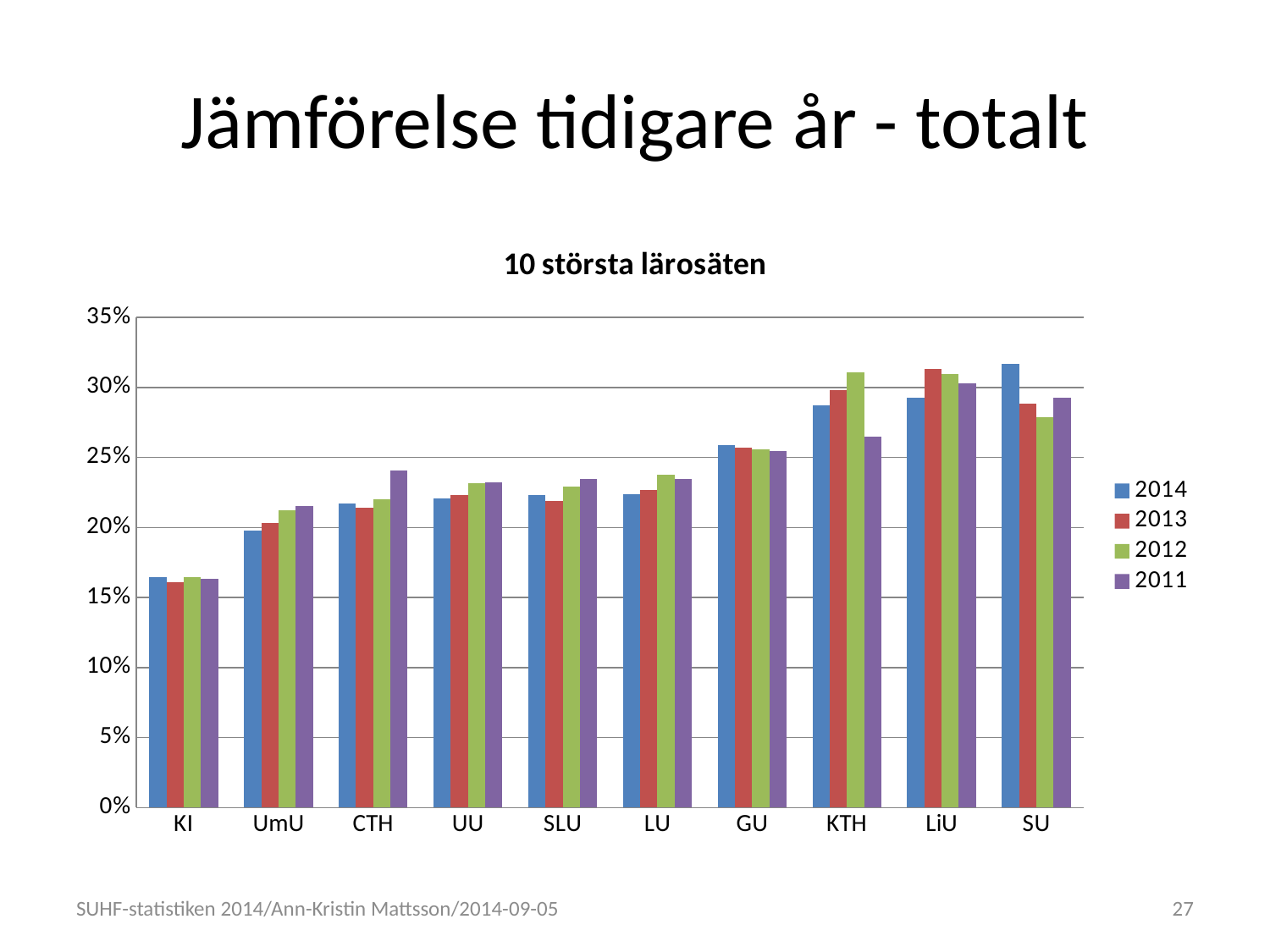
How many institutions (categories) are shown on the x axis of the chart? 10 What is the title of the chart? 10 största lärosäten Which is larger, the 2014 value for KI or the 2014 value for KTH? KTH Is the value for CTH in 2011 greater or less than 25%? less Is the value for SU in 2014 greater or less than 30%? greater Do the 2014 values generally rise or fall moving from KI on the left to SU on the right? rise Which institution has the highest value for 2014? SU What kind of chart is shown on the slide? bar chart Which institution has the lowest value for 2011? KI How many series does the legend list? 4 Which institution has the lowest value for 2014? KI Is the value for KI in 2014 greater or less than 20%? less